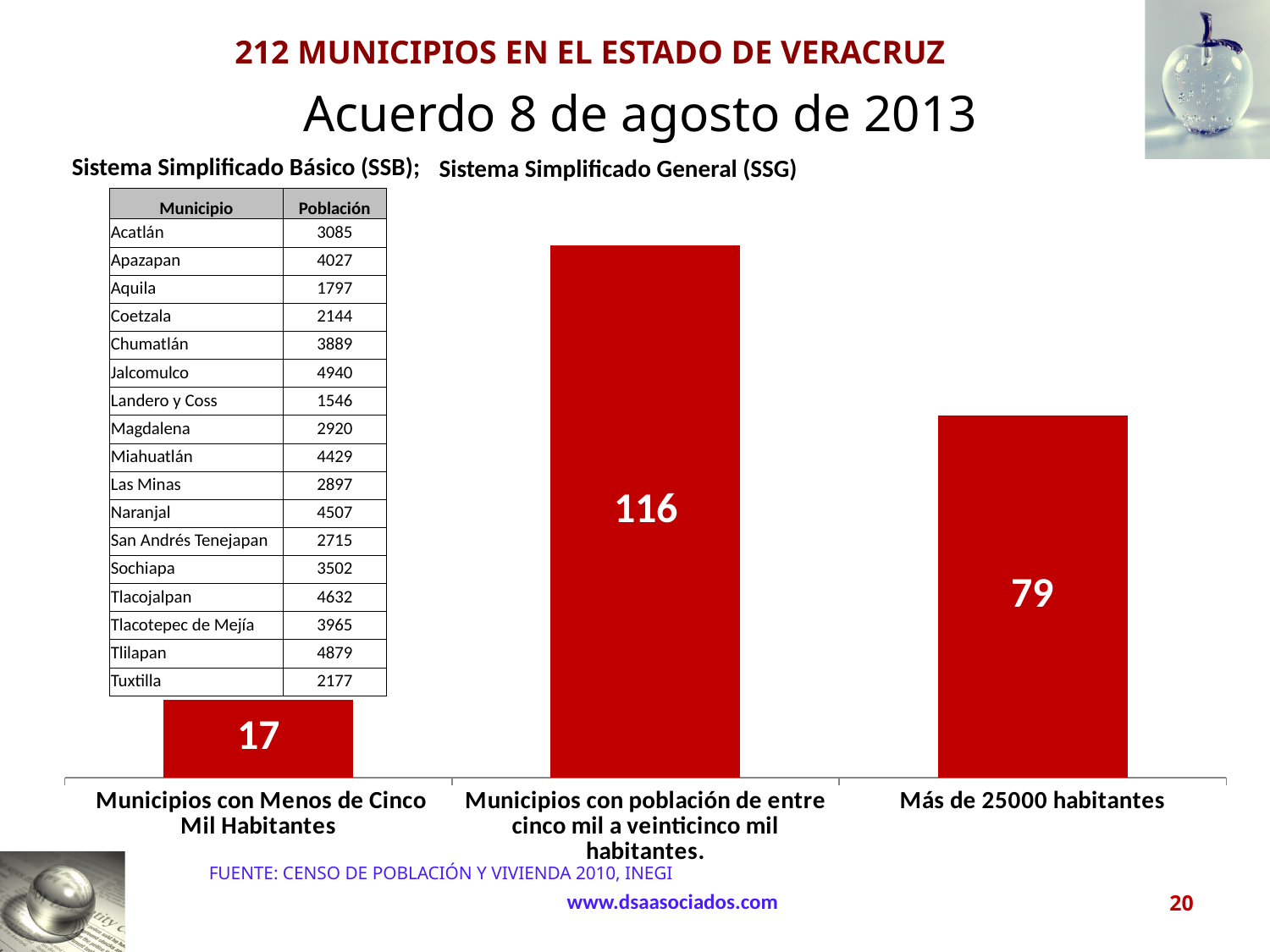
Which is larger: the value for 'Más de 25000 habitantes' or for 'Municipios con Menos de Cinco Mil Habitantes'? Más de 25000 habitantes What is the value for 'Municipios con población de entre cinco mil a veinticinco mil habitantes.'? 116 How many categories are shown in the bar chart? 3 What colour are the bars in the chart? Red What is the difference between the 'Más de 25000 habitantes' value and the 'Menos de Cinco Mil Habitantes' value? 62 What is the value for 'Más de 25000 habitantes'? 79 What type of chart is shown on the slide? Bar chart How many municipalities are in the category 'Municipios con Menos de Cinco Mil Habitantes'? 17 Which category has the lowest value? Municipios con Menos de Cinco Mil Habitantes What is the total of the three bar values? 212 Which category has the highest value? Municipios con población de entre cinco mil a veinticinco mil habitantes. What is the difference between the values for the 5,000–25,000 category and the 'Más de 25000 habitantes' category? 37